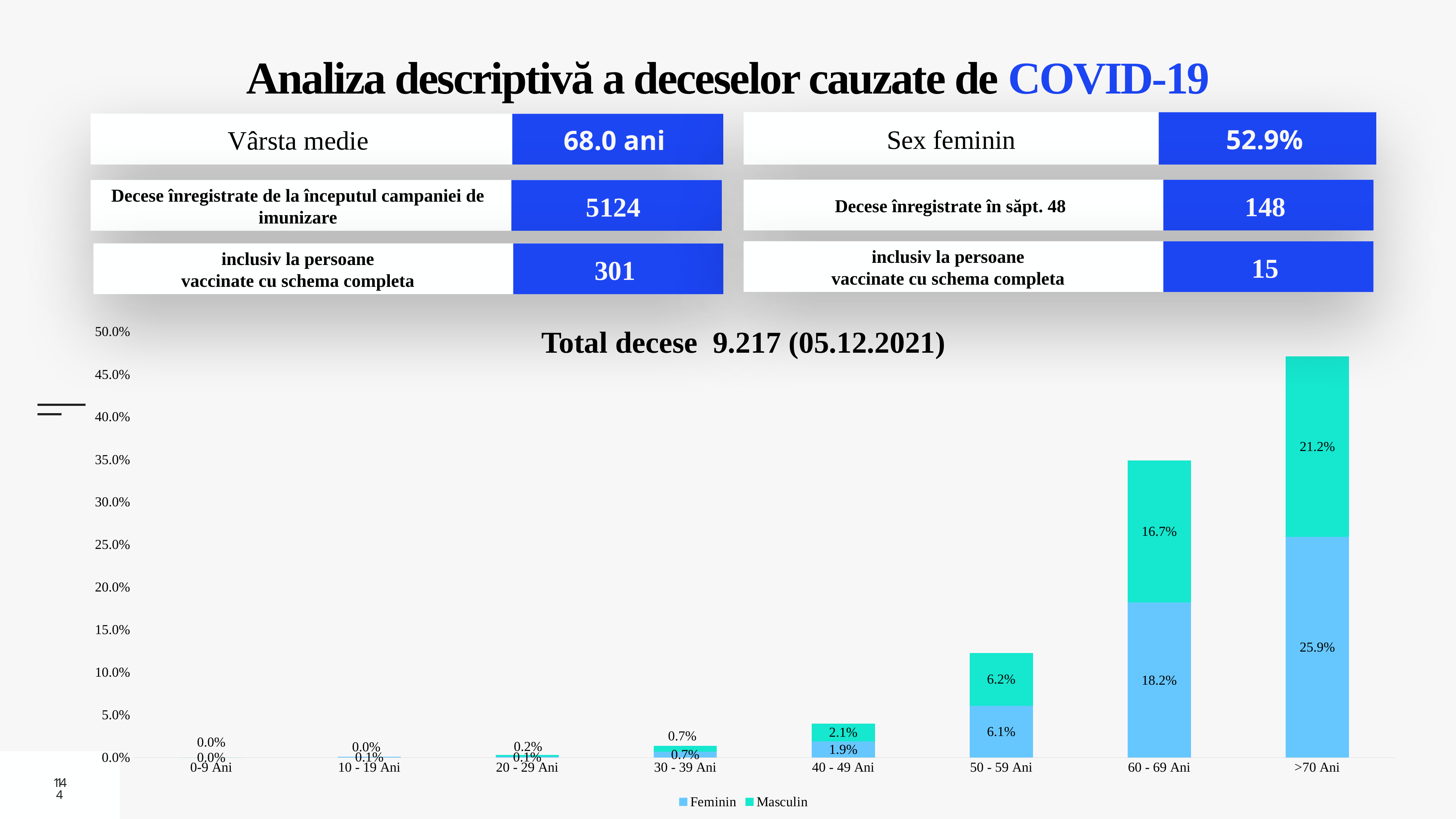
What is the Feminin value for the >70 Ani age group? 25.9% Which age group has the highest Feminin value? >70 Ani What kind of chart is shown on the slide? Stacked bar chart What is the Masculin value for the 50 - 59 Ani age group? 6.2% What is the Feminin value for the 40 - 49 Ani age group? 1.9% What is the total of the stacked bar for the 60 - 69 Ani age group? 34.9% How many series does the legend list? 2 What is the title of the chart? Total decese 9.217 (05.12.2021) How many age groups are shown on the x axis? 8 Which is larger for the 60 - 69 Ani age group, the Feminin value or the Masculin value? Feminin What is the difference between the Feminin and Masculin values for the >70 Ani age group? 4.7% What is the Masculin value for the 60 - 69 Ani age group? 16.7%